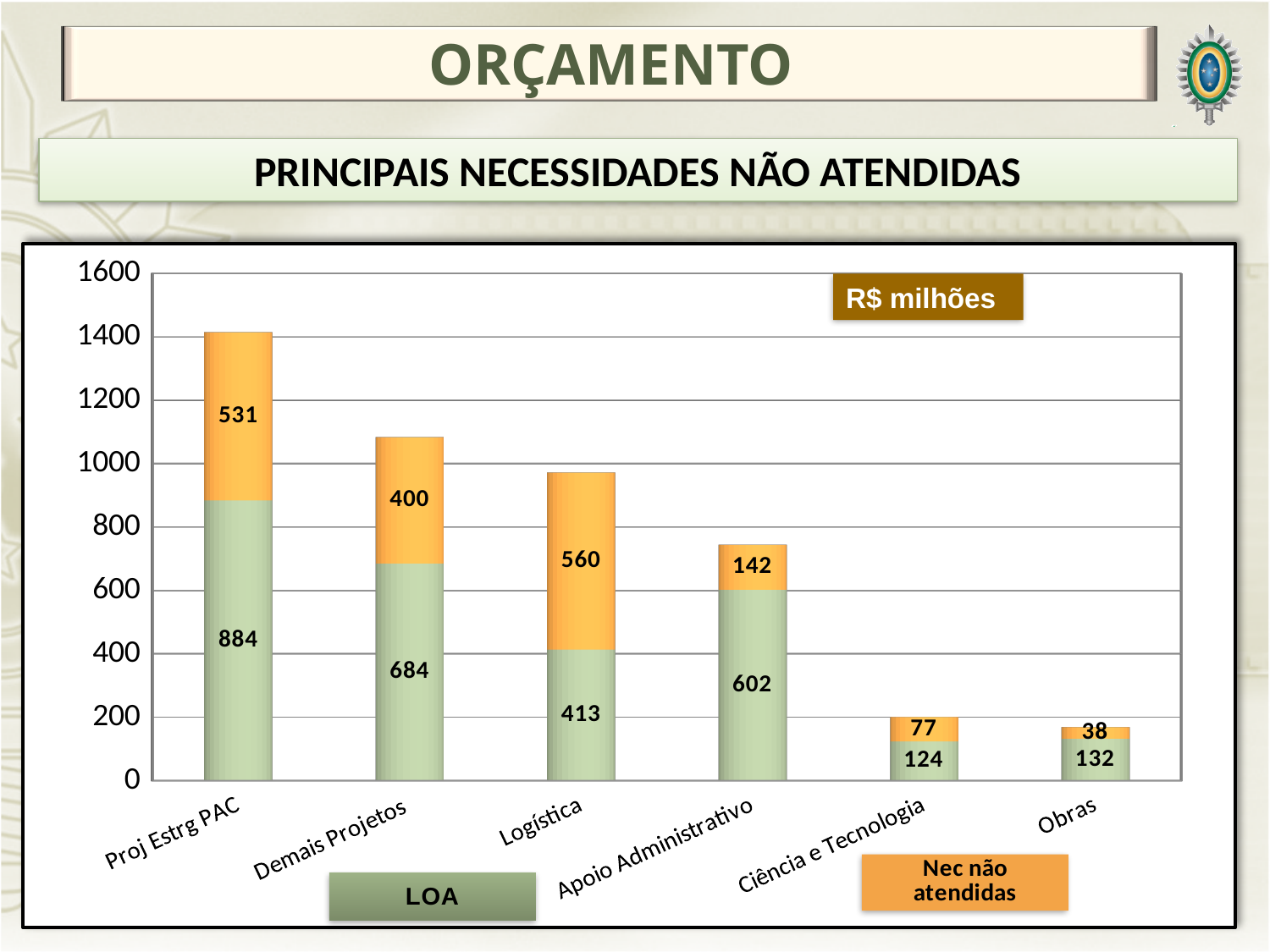
What is the difference between the LOA values for Proj Estrg PAC and Demais Projetos? 200 What is the LOA value for Logística? 413 Which category has the lowest LOA value? Ciência e Tecnologia What is the Nec não atendidas value for Demais Projetos? 400 What is the LOA value for Apoio Administrativo? 602 How many categories are shown on the x axis? 6 What kind of chart is shown on the slide? Stacked bar chart How many series does the legend list? 2 What is the total of the stacked bar for Proj Estrg PAC? 1415 Which is larger for Logística: the LOA value or the Nec não atendidas value? Nec não atendidas What is the total of the stacked bar for Obras? 170 Which category has the highest Nec não atendidas value? Logística